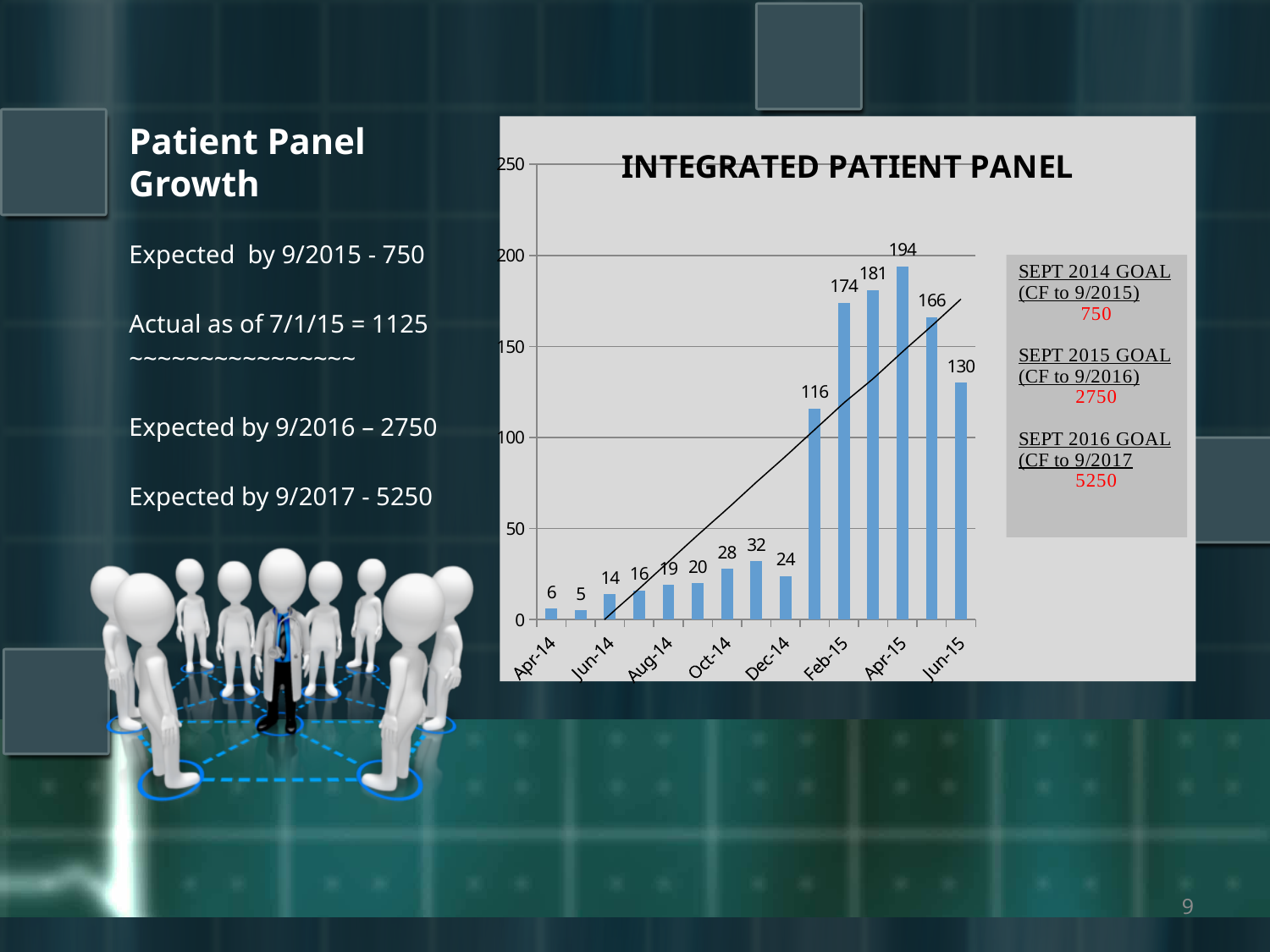
What is the title of the chart on the slide? INTEGRATED PATIENT PANEL Which month has the highest value in the INTEGRATED PATIENT PANEL chart? Apr-15 What is the value for Apr-15 in the INTEGRATED PATIENT PANEL chart? 194 What is the value for Feb-15 in the INTEGRATED PATIENT PANEL chart? 174 What is the difference between the values for Apr-15 and Jun-15 in the INTEGRATED PATIENT PANEL chart? 64 What is the value for Jun-15 in the INTEGRATED PATIENT PANEL chart? 130 Which is larger in the INTEGRATED PATIENT PANEL chart, the value for Feb-15 or the value for Jun-15? Feb-15 How many bars are plotted in the INTEGRATED PATIENT PANEL chart? 15 What is the value for Apr-14 in the INTEGRATED PATIENT PANEL chart? 6 What is the smallest value shown in the INTEGRATED PATIENT PANEL chart? 5 What is the value for Oct-14 in the INTEGRATED PATIENT PANEL chart? 28 What type of chart is the INTEGRATED PATIENT PANEL chart? bar chart